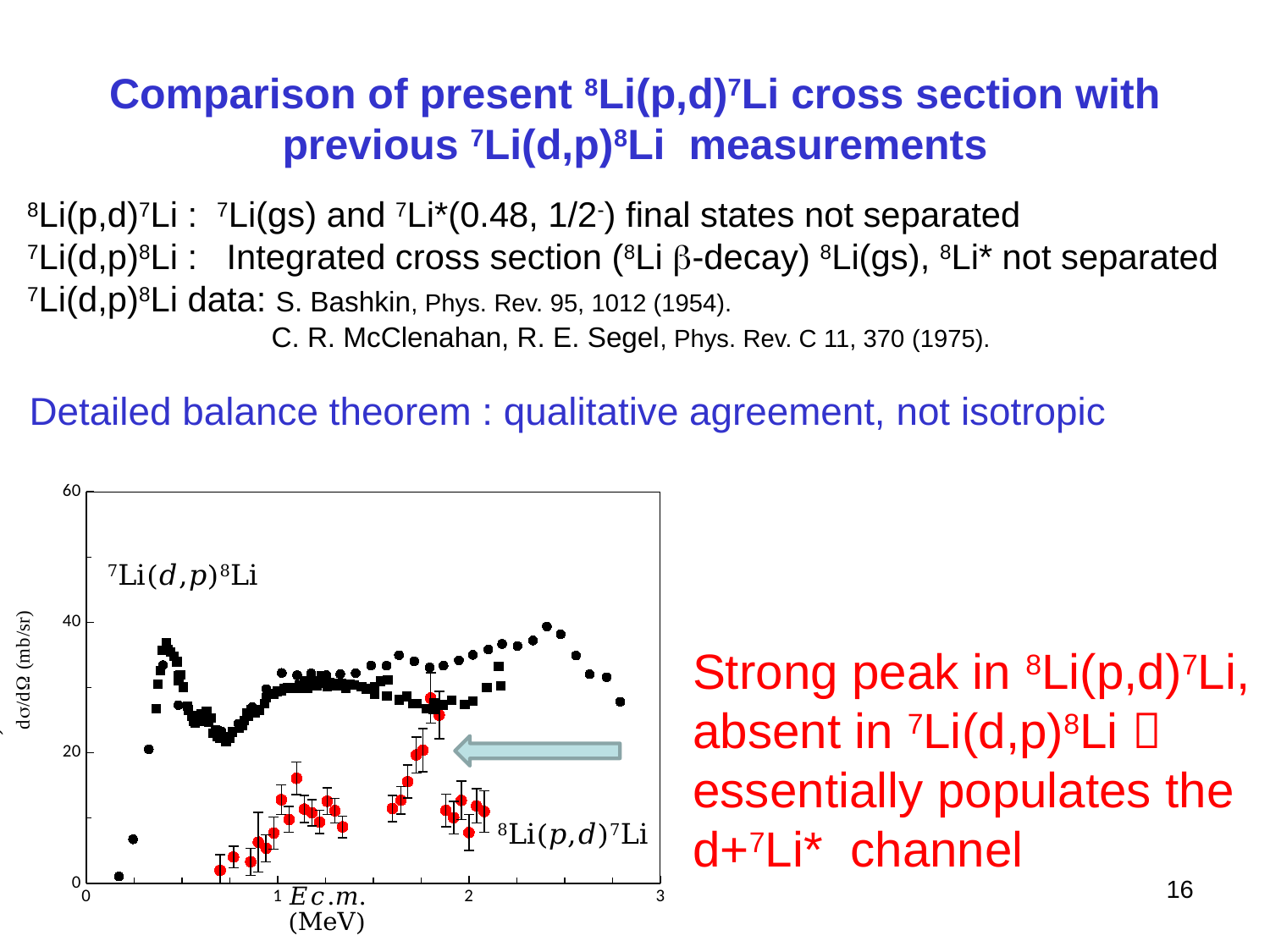
Do the 8Li(p,d)7Li data (red points) rise or fall between about 1.5 MeV and 1.8 MeV? rise What is the label of the x axis of the chart? E c.m. (MeV) Is the peak value of the 8Li(p,d)7Li data (red points) greater or less than 40? less Which data set has the larger cross section values overall, 7Li(d,p)8Li or 8Li(p,d)7Li? 7Li(d,p)8Li What is the highest value shown on the y axis of the chart? 60 Is the value of the 7Li(d,p)8Li data at about 0.4 MeV greater or less than 20? greater What kind of chart is shown on the slide? scatter plot Is the value of the 7Li(d,p)8Li data at about 0.4 MeV greater or less than 40? less What is the label of the y axis of the chart? dσ/dΩ (mb/sr)